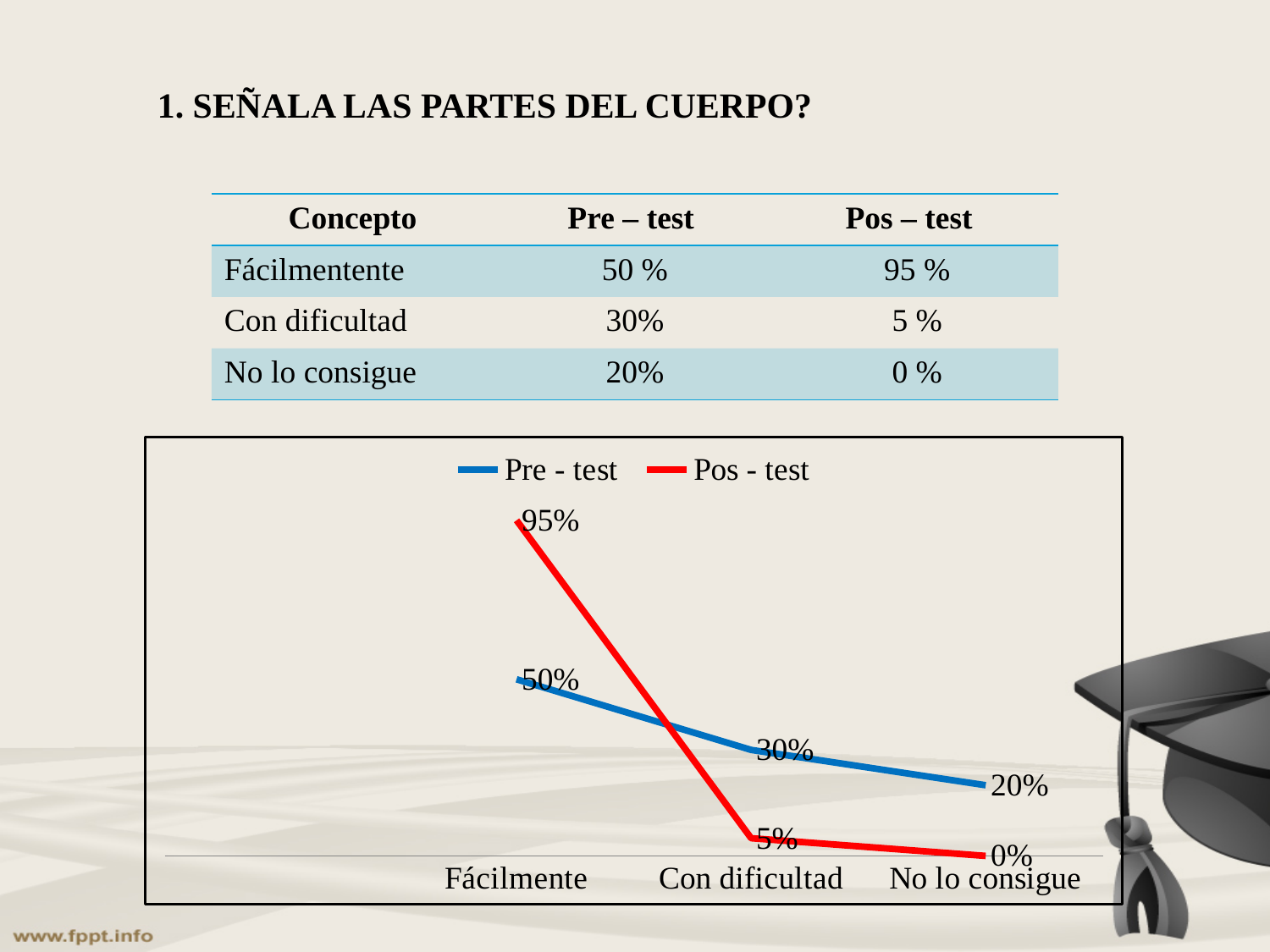
How many series does the chart legend list? 2 For Con dificultad, which series has the larger value in the chart, Pre - test or Pos - test? Pre - test What kind of chart is shown on the slide? line chart Which category has the lowest Pre - test value in the chart? No lo consigue How many categories are plotted along the x axis of the chart? 3 What is the difference between the Pos - test and Pre - test values for Fácilmente in the chart? 45% Does the Pre - test line rise or fall from Fácilmente to No lo consigue? fall Which category has the highest Pos - test value in the chart? Fácilmente What is the Pre - test value for No lo consigue in the chart? 20% What is the Pos - test value for Fácilmente in the chart? 95% What is the Pos - test value for No lo consigue in the chart? 0% What is the Pre - test value for Con dificultad in the chart? 30%